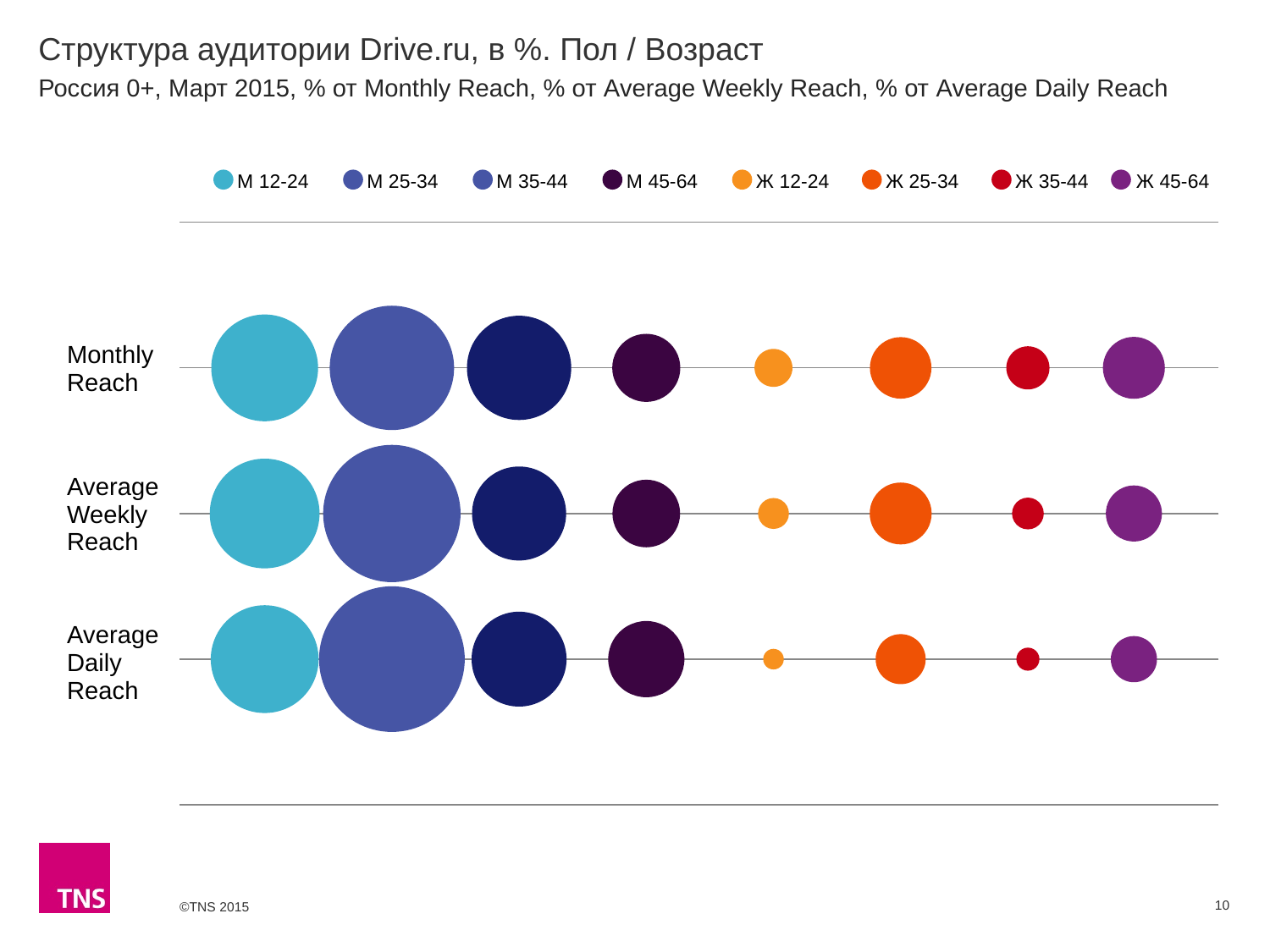
In the Average Daily Reach row, which bubble is larger: М 25-34 or Ж 12-24? М 25-34 In the Monthly Reach row, which bubble is larger: М 12-24 or М 45-64? М 12-24 Which series has the largest bubble in the Average Daily Reach row? М 25-34 What is the title of the chart on the slide? Структура аудитории Drive.ru, в %. Пол / Возраст Does the bubble for Ж 12-24 grow or shrink going from Monthly Reach to Average Daily Reach? shrink How many reach categories (rows) are plotted on the chart? 3 Which series has the largest bubble in the Monthly Reach row? М 25-34 Does the bubble for М 25-34 grow or shrink going from Monthly Reach to Average Daily Reach? grow What kind of chart is shown on the slide? bubble chart Which series has the largest bubble in the Average Weekly Reach row? М 25-34 In the Monthly Reach row, which bubble is larger: Ж 25-34 or Ж 35-44? Ж 25-34 How many series does the legend list? 8